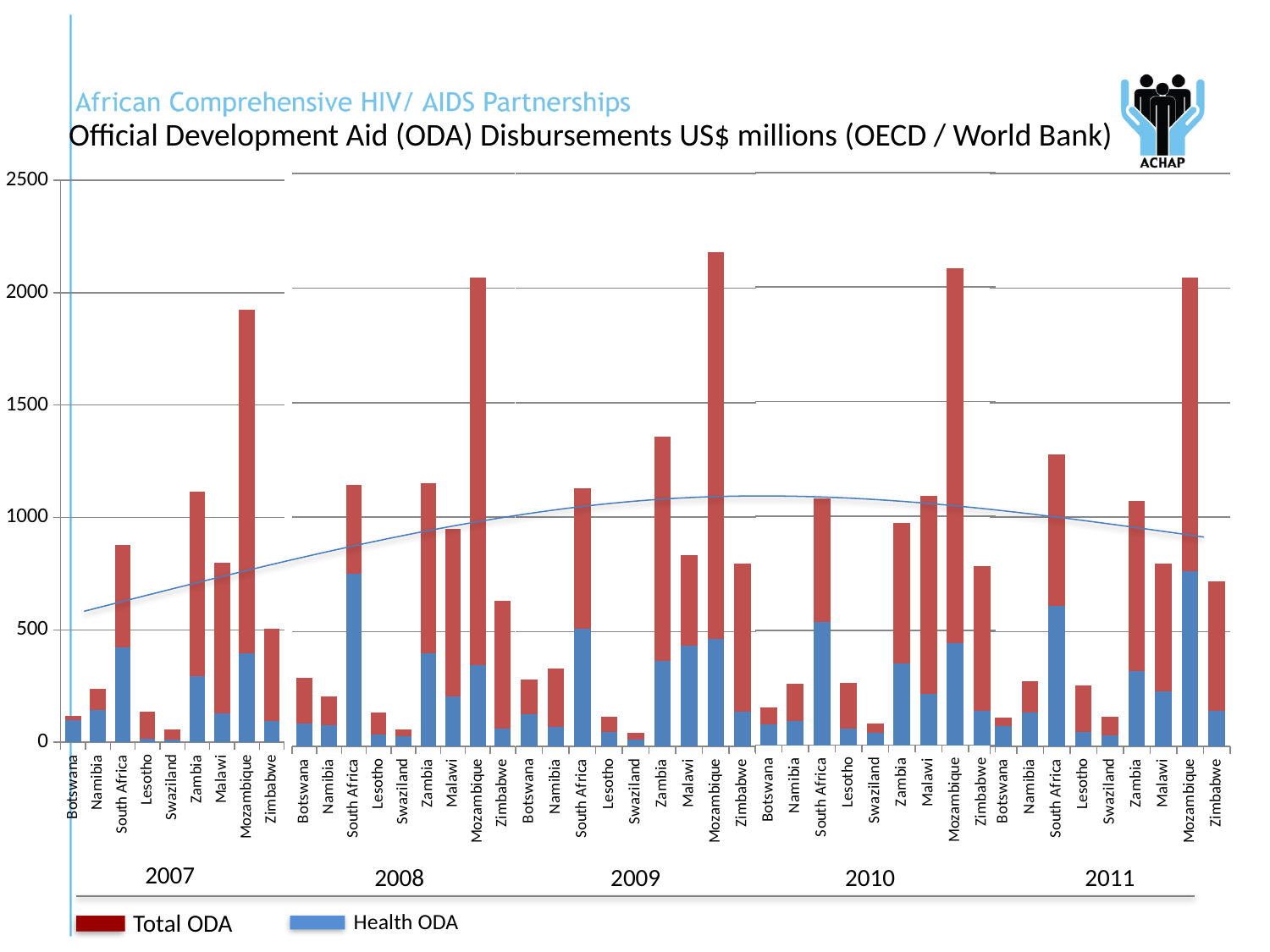
What kind of chart is shown on the slide? Stacked bar chart Which is larger, the bar for Zambia in 2009 or the bar for South Africa in 2009? Zambia in 2009 Is the value for Zimbabwe in 2011 greater or less than 1000? less Which colour represents Health ODA in the legend? Blue Is the value for Mozambique in 2007 greater or less than 1500? greater Which country has the lowest bar in 2007? Swaziland Is the value for Zambia in 2009 greater or less than 1000? greater How many series does the legend list? 2 How many countries are shown for each year? 9 Which is larger, the bar for Mozambique in 2007 or the bar for Mozambique in 2008? Mozambique in 2008 Which country has the highest bar in 2007? Mozambique How many years are shown along the x axis? 5